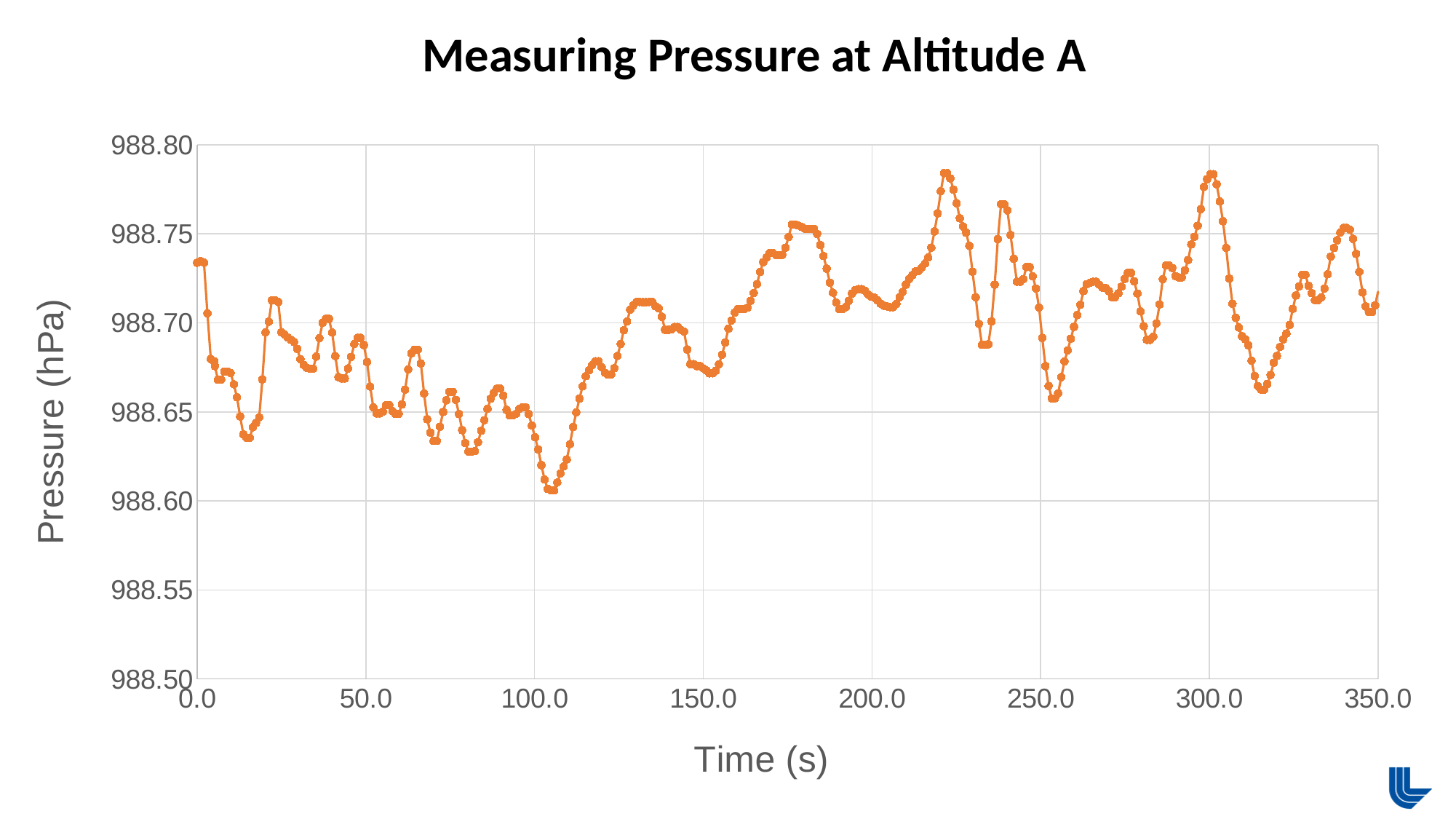
What is the title of the chart? Measuring Pressure at Altitude A Is the pressure value at time 300.0 s greater or less than 988.75? greater Is the pressure value at time 150.0 s greater or less than 988.70? less Is the lowest pressure value on the chart greater or less than 988.65? less What kind of chart is shown on the slide? Line chart What is the label of the vertical axis? Pressure (hPa)